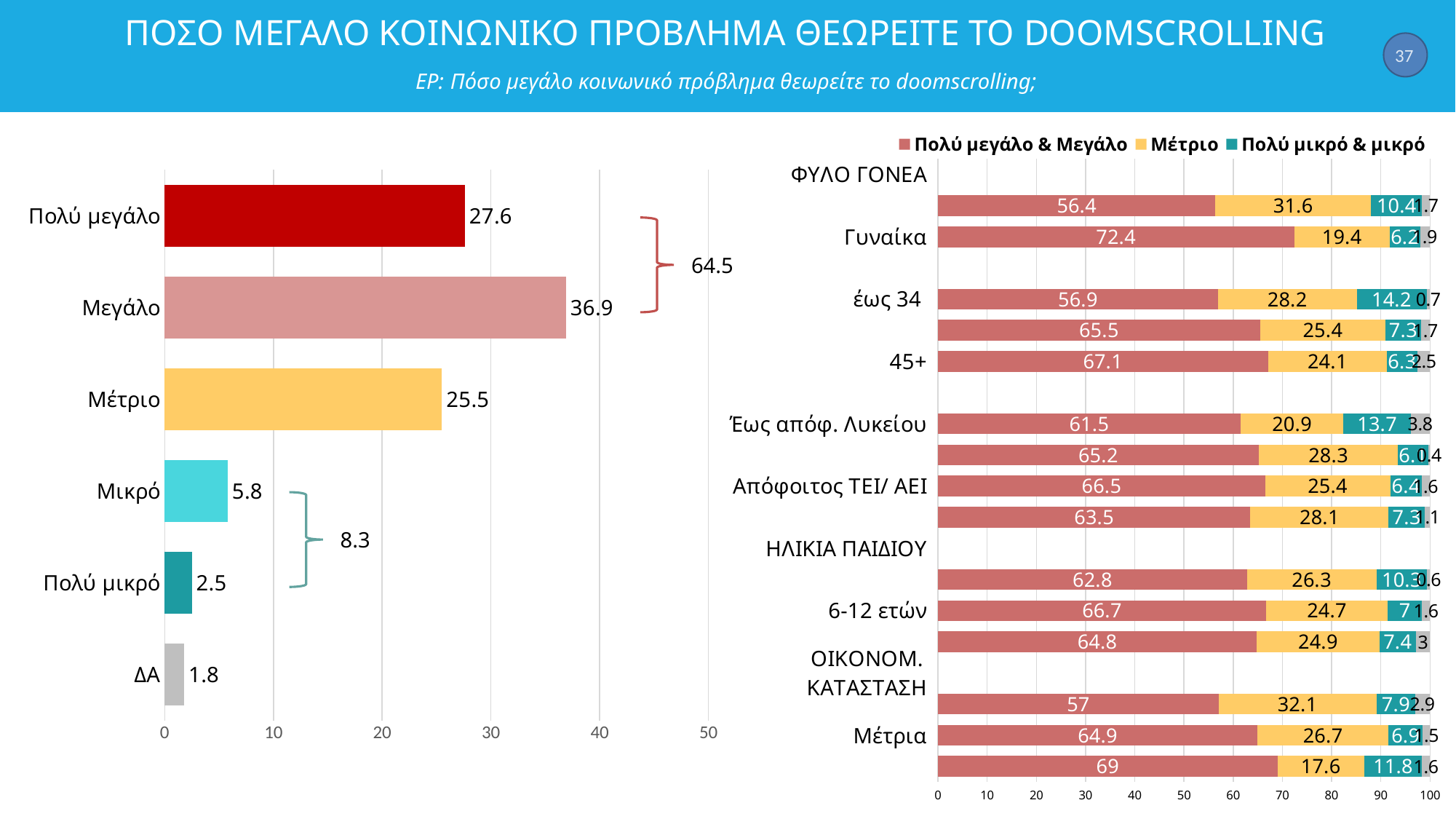
In the left bar chart, what is the value for Πολύ μικρό? 2.5 In the right stacked bar chart, which is larger: the Πολύ μεγάλο & Μεγάλο value for Γυναίκα or for 45+? Γυναίκα In the left bar chart, what is the value for Μεγάλο? 36.9 In the right stacked bar chart, what is the Μέτριο value for έως 34? 28.2 In the right stacked bar chart, what is the Πολύ μικρό & μικρό value for Έως απόφ. Λυκείου? 13.7 What kind of chart is the chart on the left of the slide? bar chart In the left bar chart, what is the difference between the values for Μεγάλο and Πολύ μεγάλο? 9.3 In the left bar chart, how many categories are shown? 6 In the right stacked bar chart, what is the Πολύ μεγάλο & Μεγάλο value for Γυναίκα? 72.4 In the left bar chart, which category has the lowest value? ΔΑ In the left bar chart, which category has the highest value? Μεγάλο How many series does the legend of the right stacked bar chart list? 3